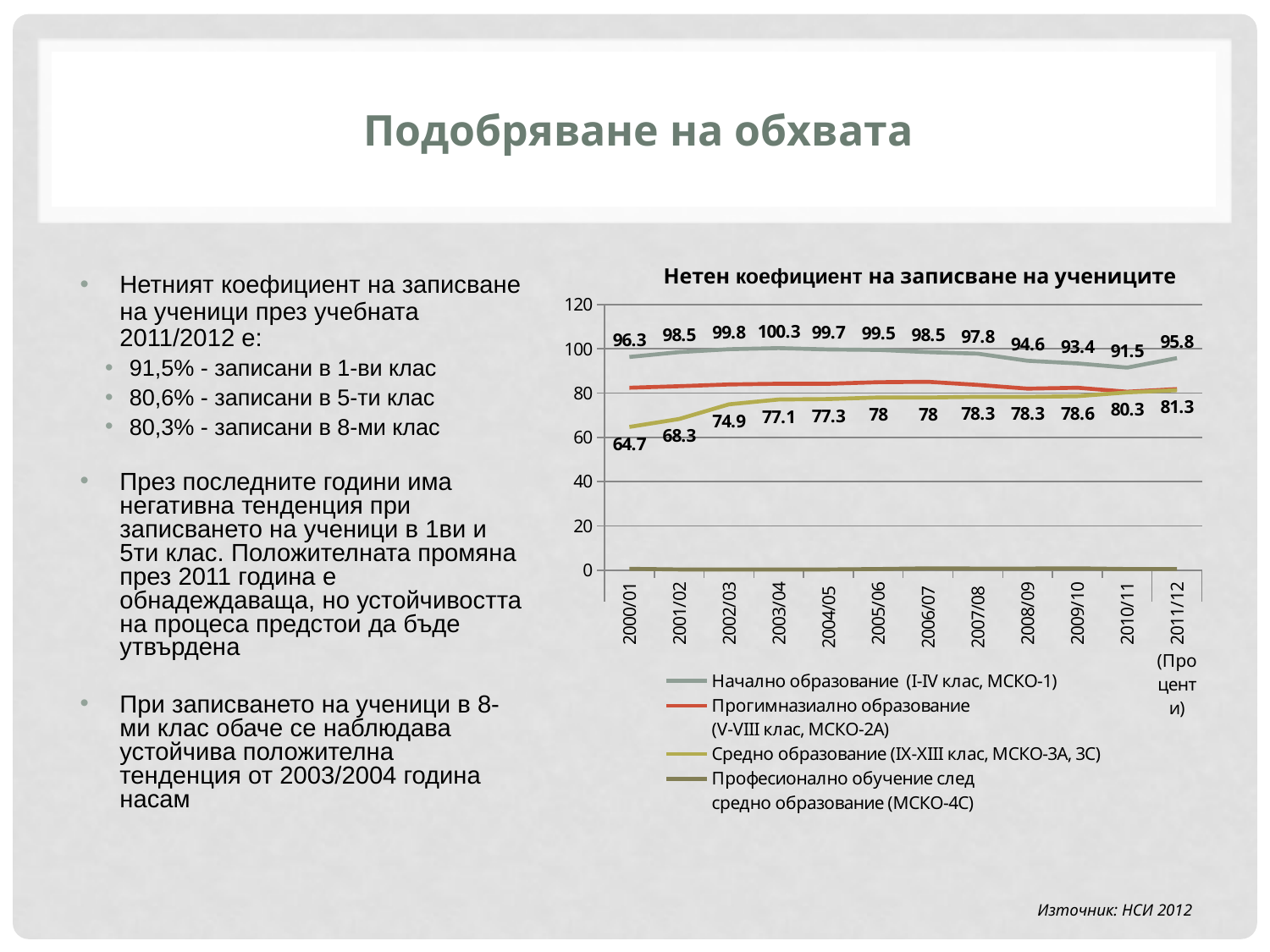
Does the Средно образование (IX-XIII клас, МСКО-3А, 3С) series generally rise or fall from 2000/01 to 2011/12? rise What is the difference between the Начално образование value in 2003/04 and its value in 2010/11? 8.8 Which is larger: the Средно образование value in 2011/12 or in 2000/01? 2011/12 What is the value for Средно образование (IX-XIII клас, МСКО-3А, 3С) in 2000/01? 64.7 How many series does the legend list? 4 In which year does Начално образование (I-IV клас, МСКО-1) reach its highest value? 2003/04 What is the value for Начално образование (I-IV клас, МСКО-1) in 2003/04? 100.3 What kind of chart is shown on the slide? line chart What is the value for Начално образование (I-IV клас, МСКО-1) in 2011/12? 95.8 In which year does Средно образование (IX-XIII клас, МСКО-3А, 3С) have its lowest value? 2000/01 How many school years are shown on the x axis? 12 Is the value for Прогимназиално образование (V-VIII клас, МСКО-2А) in 2006/07 greater or less than 80? greater